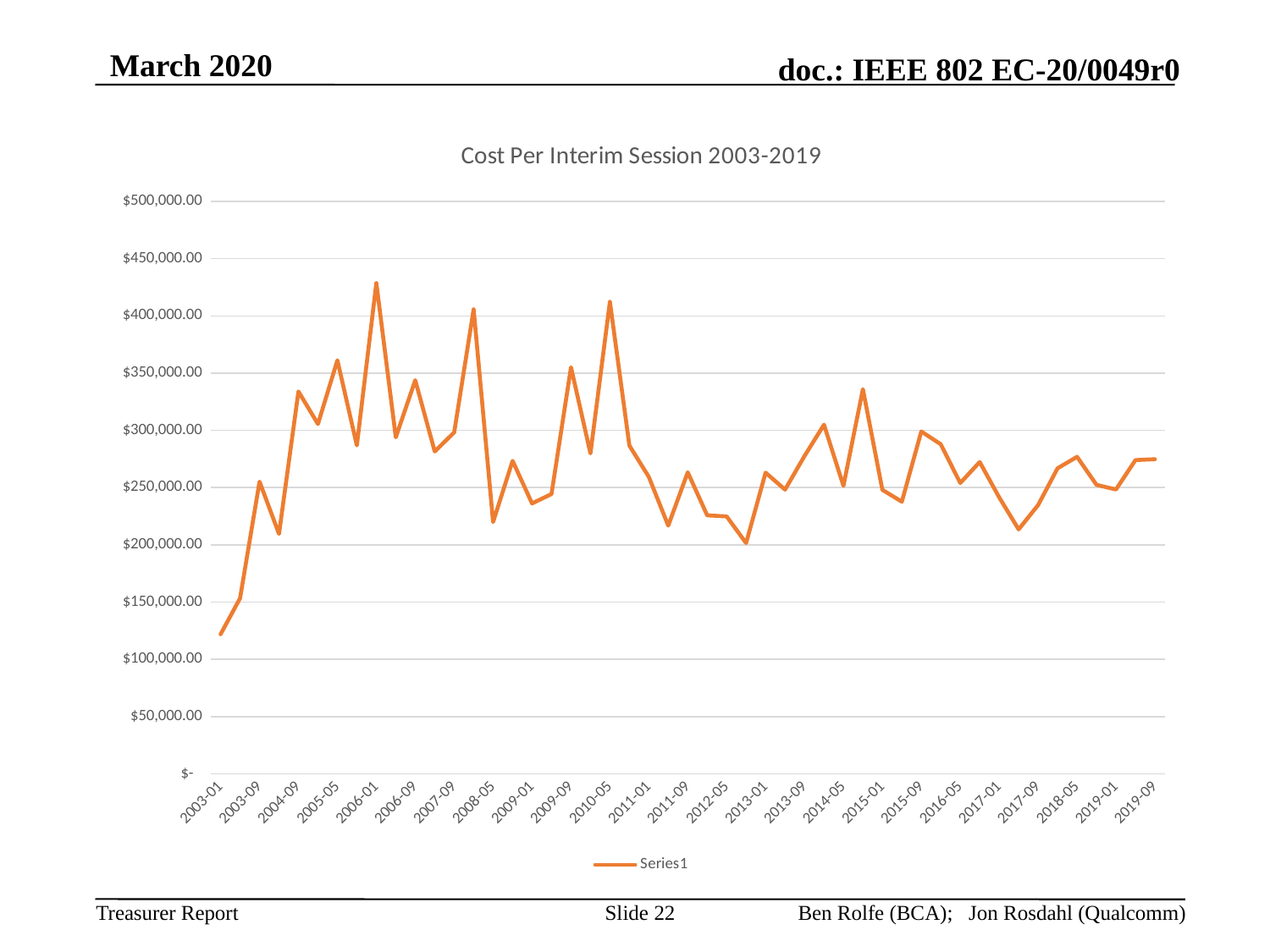
At which x-axis label does the line reach its highest value? 2006-01 What is the title of the chart? Cost Per Interim Session 2003-2019 Which is larger, the value for 2003-01 or the value for 2019-09? 2019-09 Is the value for 2017-09 greater or less than $250,000.00? less Is the value for 2019-09 greater or less than $250,000.00? greater What kind of chart is shown on the slide? Line chart Does the line rise or fall between 2003-01 and 2004-09? rise How many series does the legend list? 1 Is the value for 2006-01 greater or less than $400,000.00? greater At which x-axis label does the line reach its lowest value? 2003-01 What is the name of the series shown in the legend? Series1